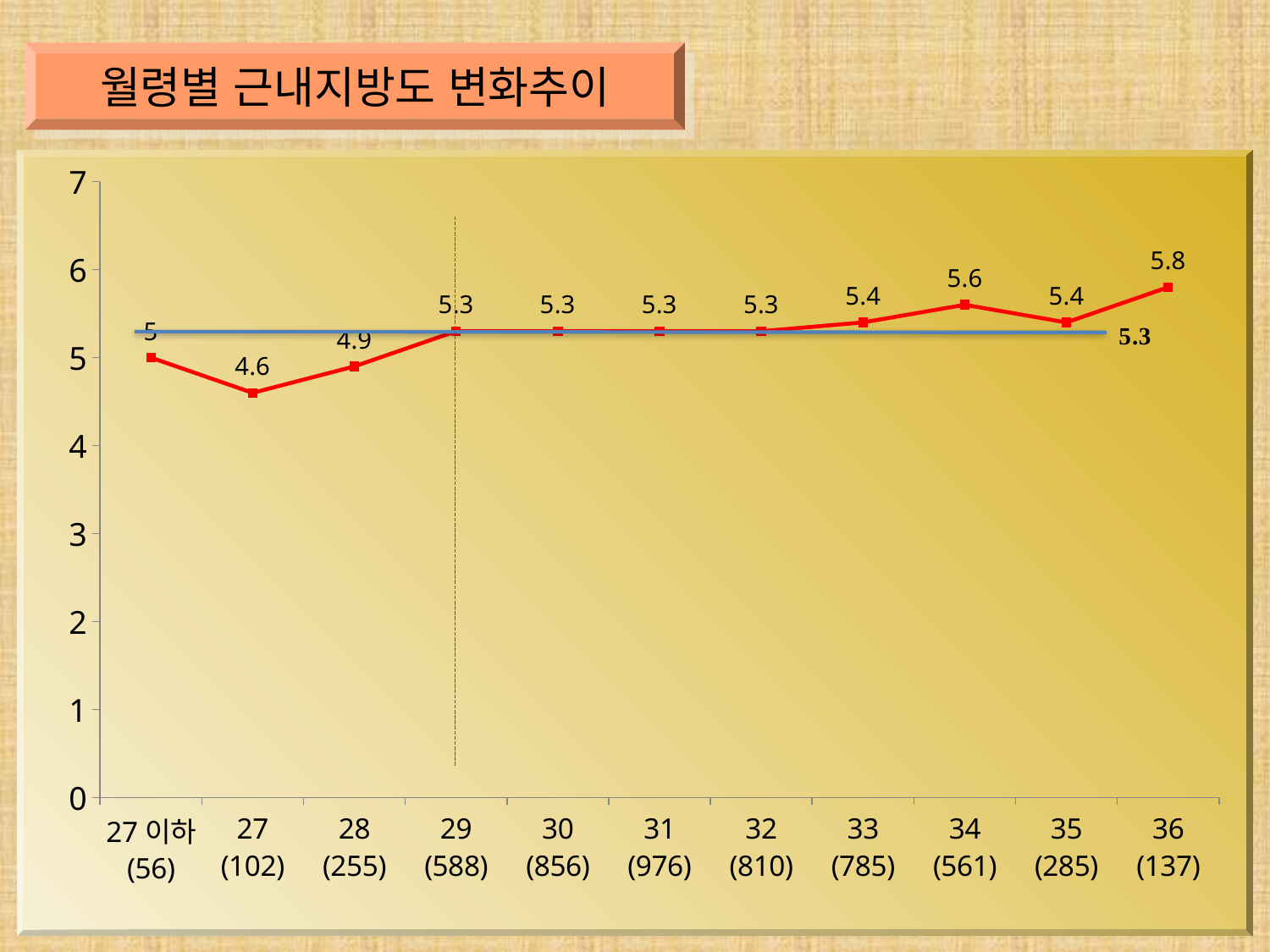
What is the value for the '27 이하' category? 5 What is the value for 27 months (27 (102))? 4.6 What is the title of the chart? 월령별 근내지방도 변화추이 Which is larger, the value for 28 months or the value for 33 months? 33 months What is the value for 36 months (36 (137))? 5.8 Which category has the lowest value on the red line? 27 (102) What is the difference between the values for 36 months and 27 months? 1.2 How many categories are shown on the x axis? 11 What value does the blue horizontal reference line mark? 5.3 What kind of chart is this? Line chart Which category has the highest value on the red line? 36 (137) What is the value for 34 months (34 (561))? 5.6